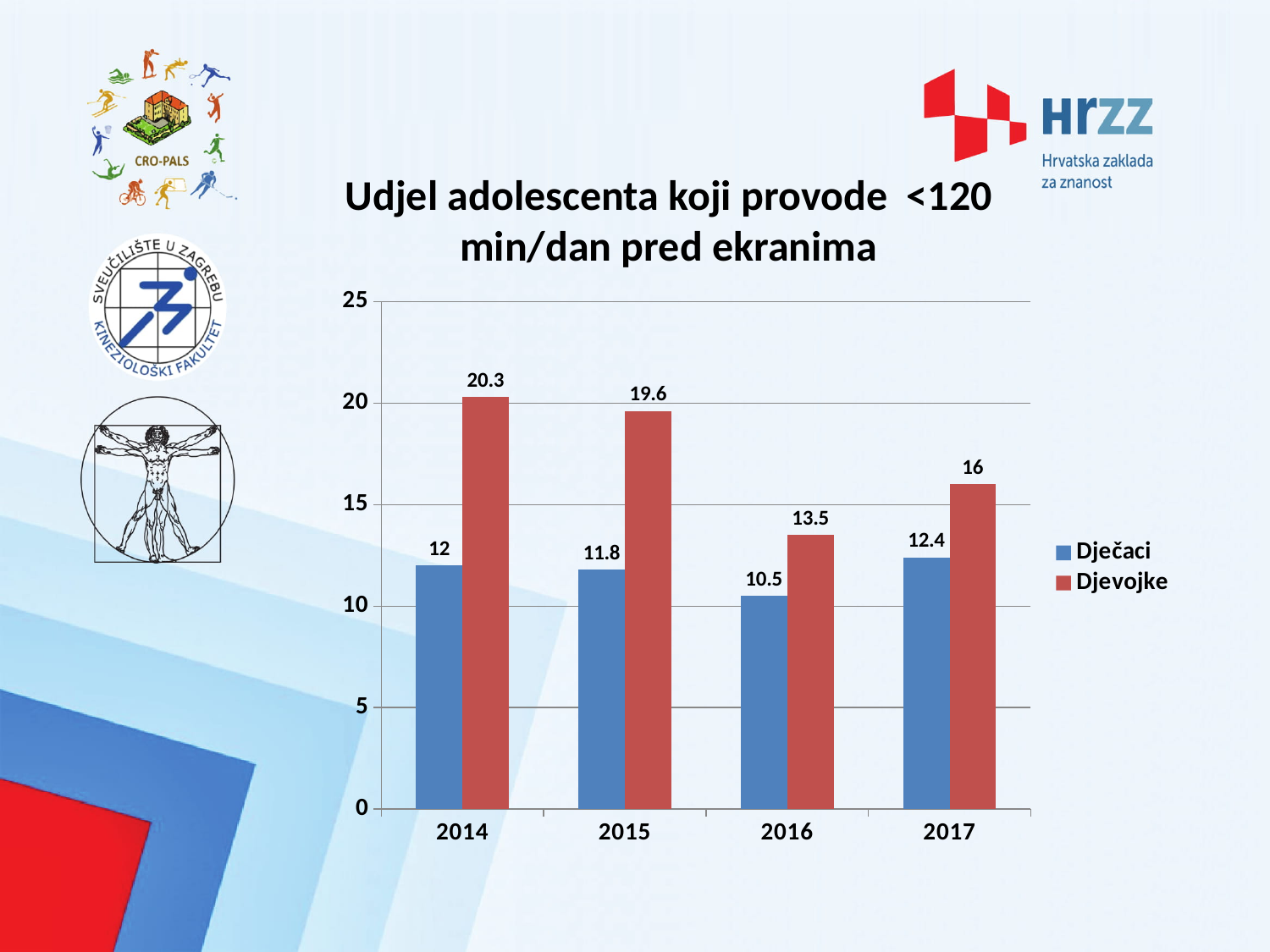
What kind of chart is shown on the slide? Bar chart In which year is the Djevojke value highest? 2014 How many years are shown on the x axis? 4 What is the value for Djevojke in 2015? 19.6 What is the value for Djevojke in 2017? 16 In which year is the Dječaci value lowest? 2016 What is the difference between the Djevojke and Dječaci values in 2014? 8.3 What is the value for Dječaci in 2014? 12 What is the value for Dječaci in 2016? 10.5 Which series is shown in red? Djevojke How many series does the legend list? 2 Which is larger in 2016, the Dječaci value or the Djevojke value? Djevojke